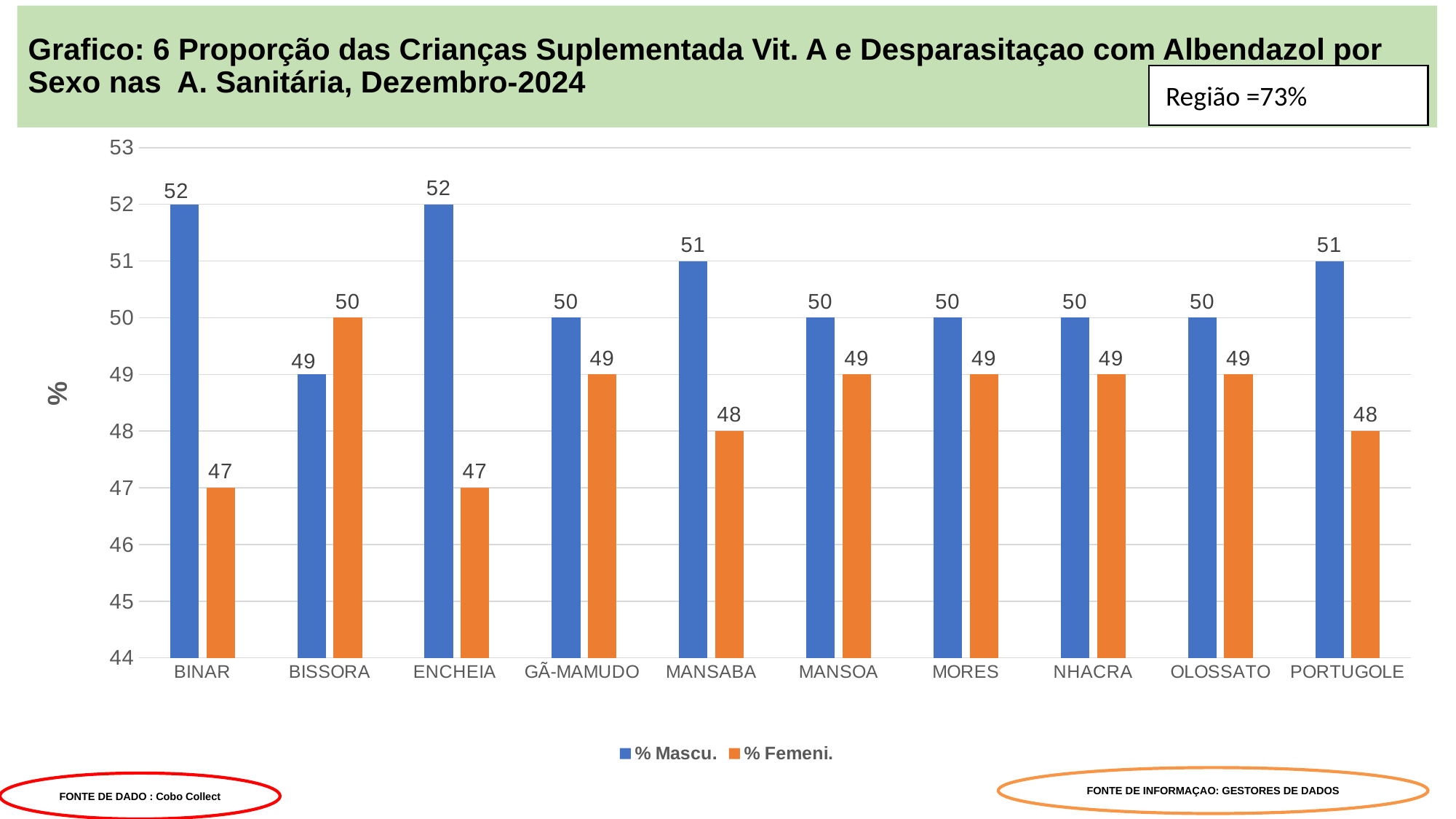
What is the % Femeni. value for PORTUGOLE? 48 Which area has the highest % Femeni. value? BISSORA Which is larger for BISSORA, % Mascu. or % Femeni.? % Femeni. What value is shown in the box labelled 'Região' at the top right of the slide? 73% What is the % Femeni. value for BISSORA? 50 What is the % Mascu. value for NHACRA? 50 What kind of chart is shown on the slide? Bar chart What is the % Mascu. value for MANSABA? 51 What is the difference between the % Mascu. and % Femeni. values for BINAR? 5 How many areas are shown on the x axis? 10 Which area has the lowest % Mascu. value? BISSORA How many series does the legend list? 2